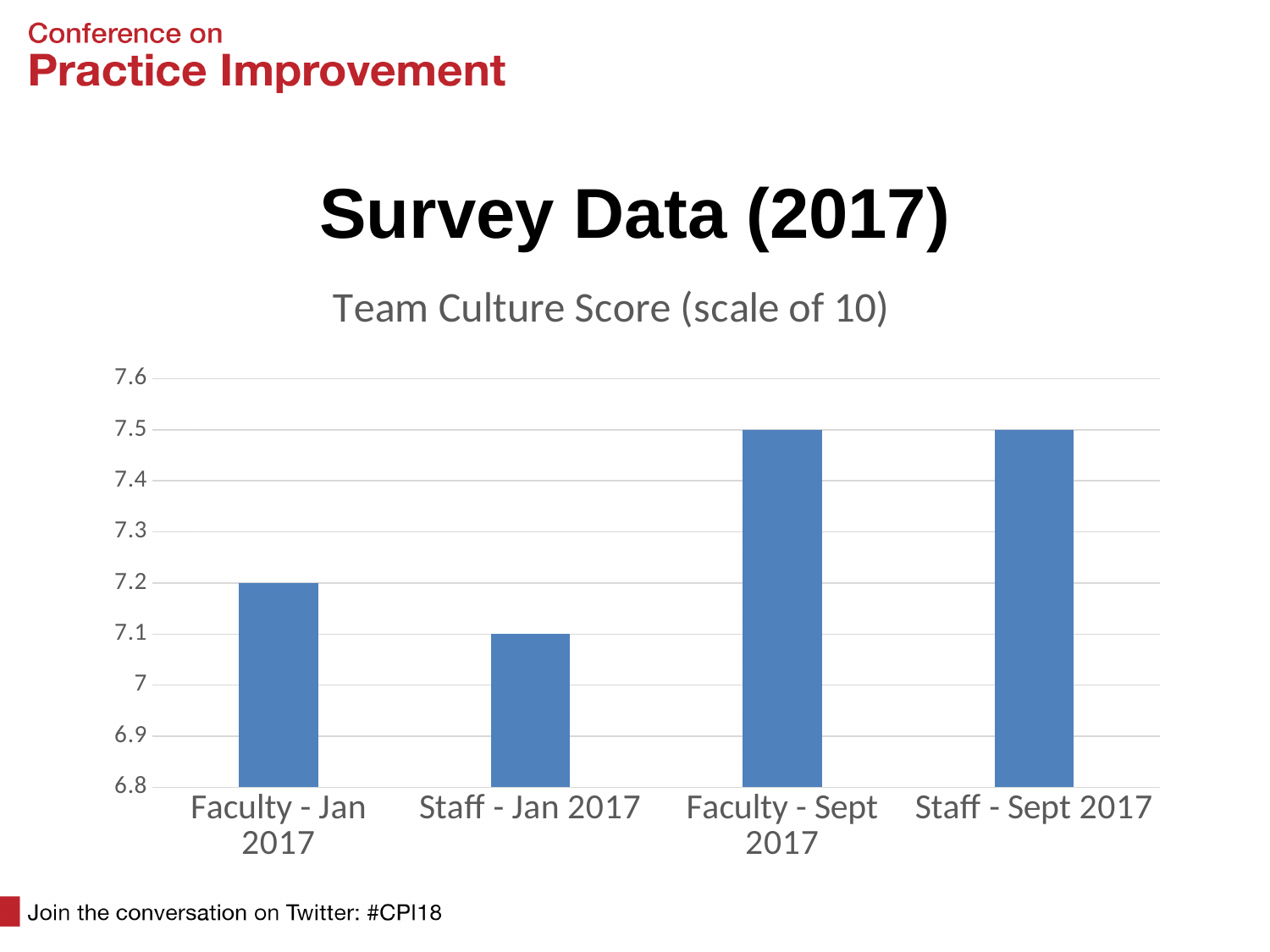
What is the Team Culture Score for Faculty - Sept 2017? 7.5 How many categories are shown on the chart? 4 What is the Team Culture Score for Faculty - Jan 2017? 7.2 Which category has the lowest Team Culture Score? Staff - Jan 2017 What is the title of the chart? Team Culture Score (scale of 10) What is the difference between the Faculty - Sept 2017 score and the Faculty - Jan 2017 score? 0.3 Which is larger, the score for Faculty - Jan 2017 or Staff - Jan 2017? Faculty - Jan 2017 Is the value for Staff - Sept 2017 greater or less than 7.3? greater What is the difference between the Staff - Sept 2017 score and the Staff - Jan 2017 score? 0.4 What is the Team Culture Score for Staff - Sept 2017? 7.5 What kind of chart is shown on the slide? bar chart What is the Team Culture Score for Staff - Jan 2017? 7.1